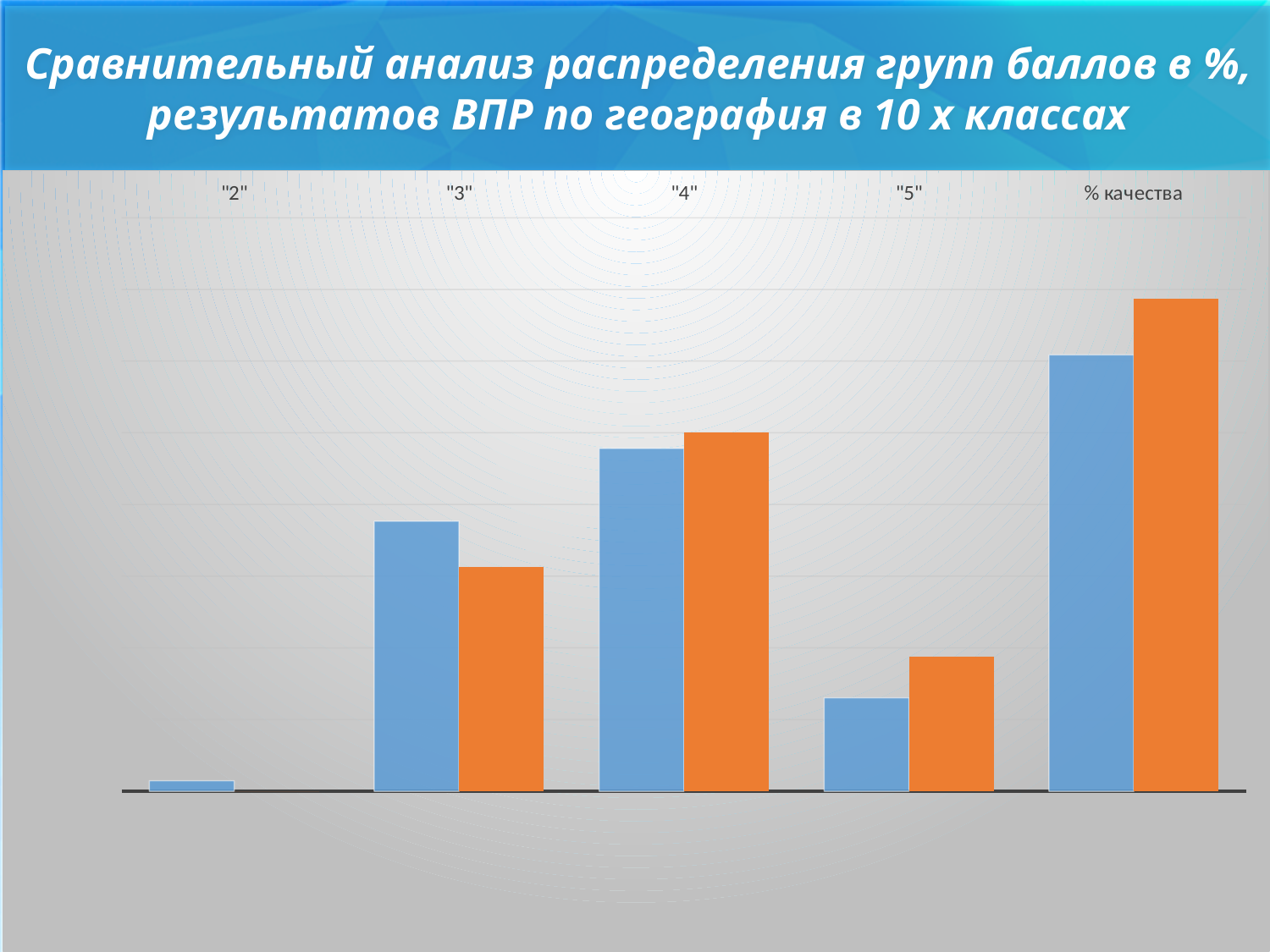
Is the orange bar for "5" taller or shorter than the orange bar for "4"? shorter Which category has the tallest orange bar? % качества What kind of chart is shown on the slide? bar chart How many categories are shown along the x axis of the chart? 5 Which subject's ВПР results does the chart title say are being compared? география For the category "3", which bar is taller, the blue one or the orange one? blue For the category "% качества", which bar is taller, the blue one or the orange one? orange Which category has the tallest blue bar? % качества What two colours are used for the bars in the chart? blue and orange Which category has the shortest blue bar? "2"